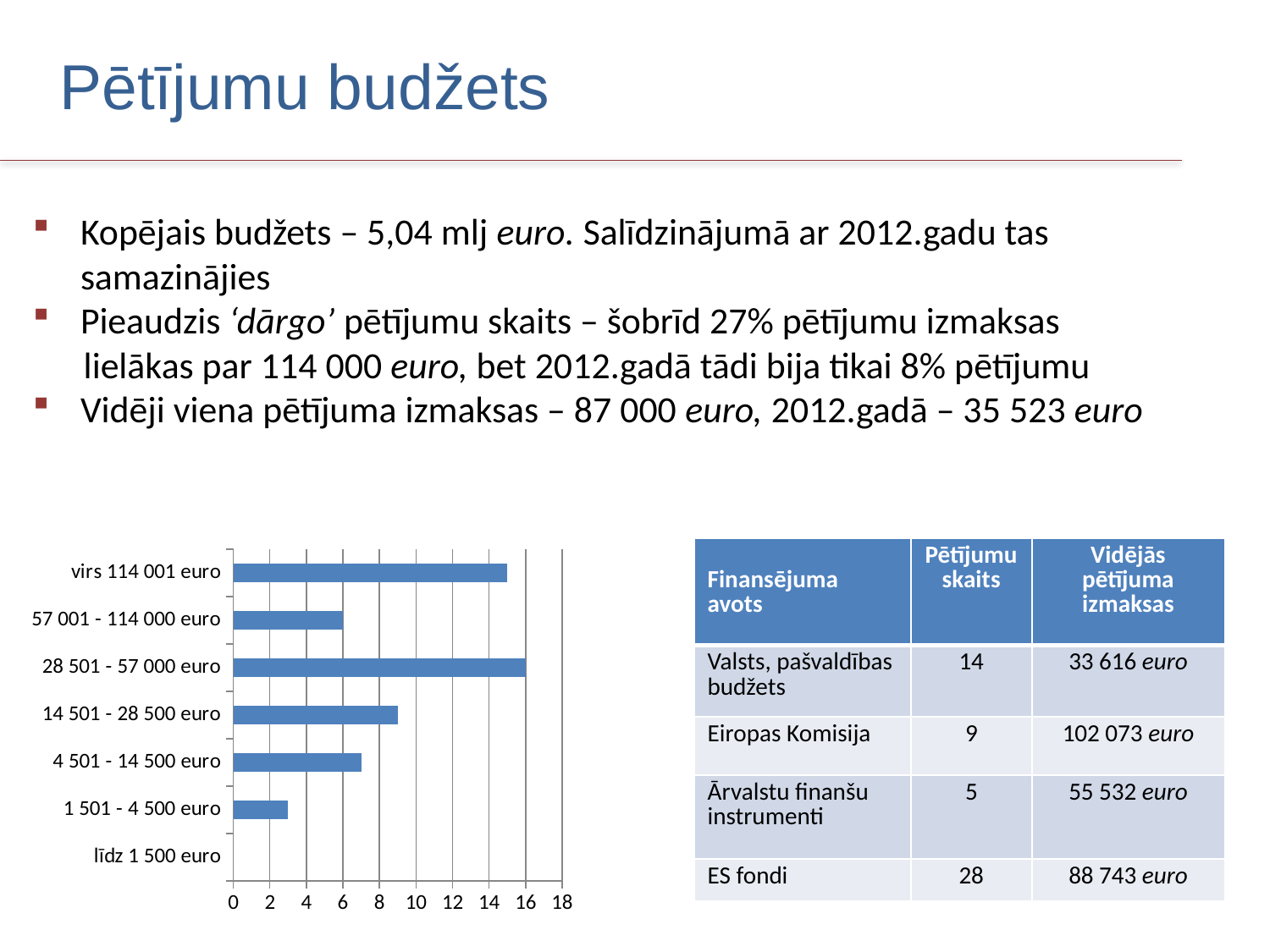
What kind of chart is shown on the slide? bar chart What is the value for the category 57 001 - 114 000 euro? 6 What is the highest tick value shown on the horizontal axis of the bar chart? 18 Which category has the highest value in the bar chart? 28 501 - 57 000 euro Which category has the lowest value in the bar chart? līdz 1 500 euro Is the value for 1 501 - 4 500 euro greater or less than 4? less Is the value for 14 501 - 28 500 euro greater or less than 8? greater Which is larger, the value for 4 501 - 14 500 euro or the value for 14 501 - 28 500 euro? 14 501 - 28 500 euro Is the value for virs 114 001 euro greater or less than 12? greater How many categories does the bar chart show? 7 Which is larger, the value for virs 114 001 euro or the value for 57 001 - 114 000 euro? virs 114 001 euro What is the value for the category 28 501 - 57 000 euro? 16